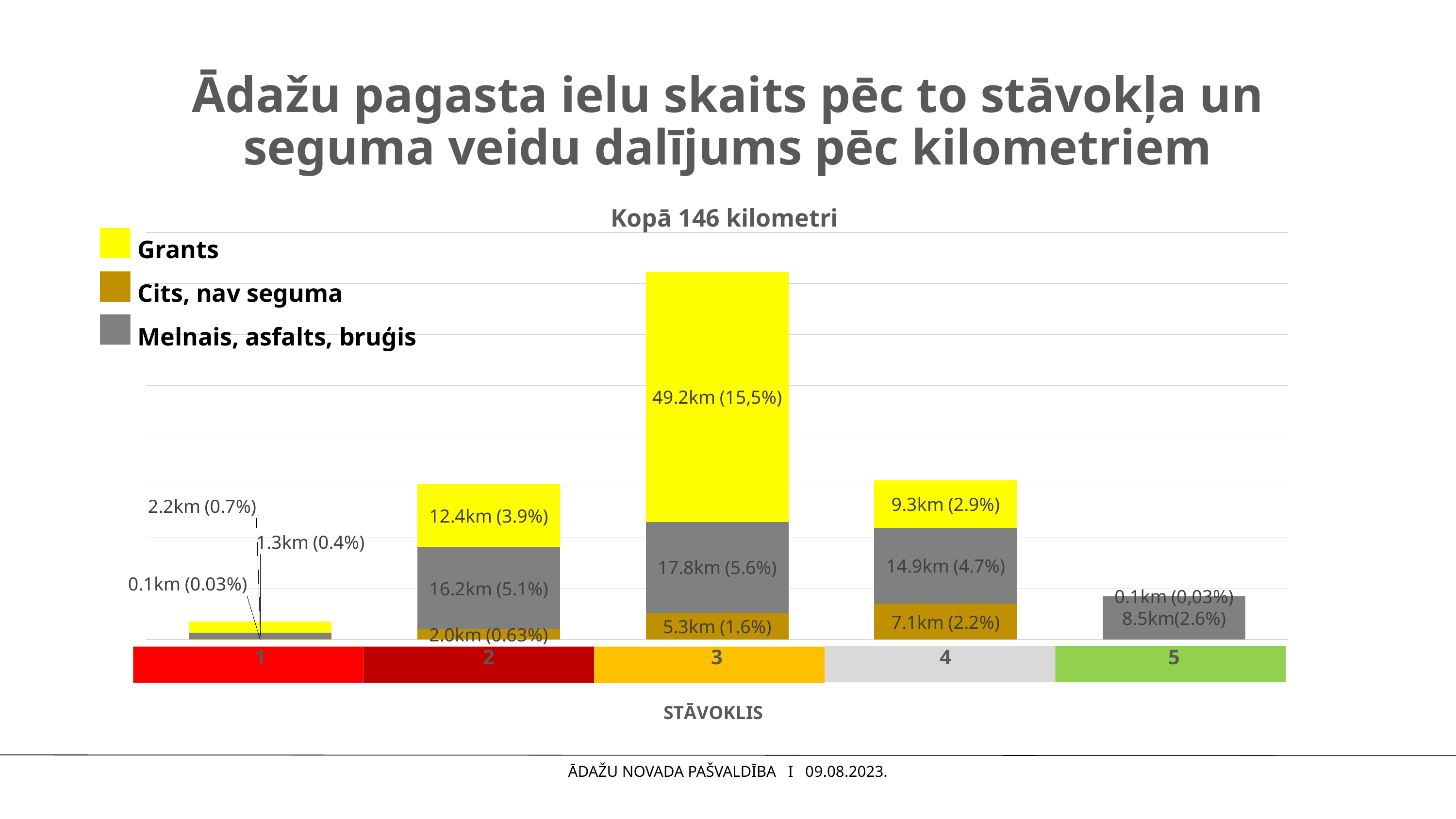
What is the difference in kilometres between the Melnais, asfalts, bruģis segments of category 3 and category 4? 2.9km Which category has the largest Grants segment? 3 How many categories (STĀVOKLIS values) are shown on the x axis? 5 How many series does the legend list? 3 What is the value of the Grants segment for category 3? 49.2km (15,5%) What kind of chart is shown on the slide? stacked bar chart What is the value of the Melnais, asfalts, bruģis segment for category 2? 16.2km (5.1%) What is the value of the Cits, nav seguma segment for category 4? 7.1km (2.2%) For category 4, which is larger: the Grants segment or the Melnais, asfalts, bruģis segment? Melnais, asfalts, bruģis What is the chart's title shown above the plot area? Kopā 146 kilometri What is the value of the Melnais, asfalts, bruģis segment for category 5? 8.5km(2.6%) What is the total length in kilometres of the stacked bar for category 2? 30.6km